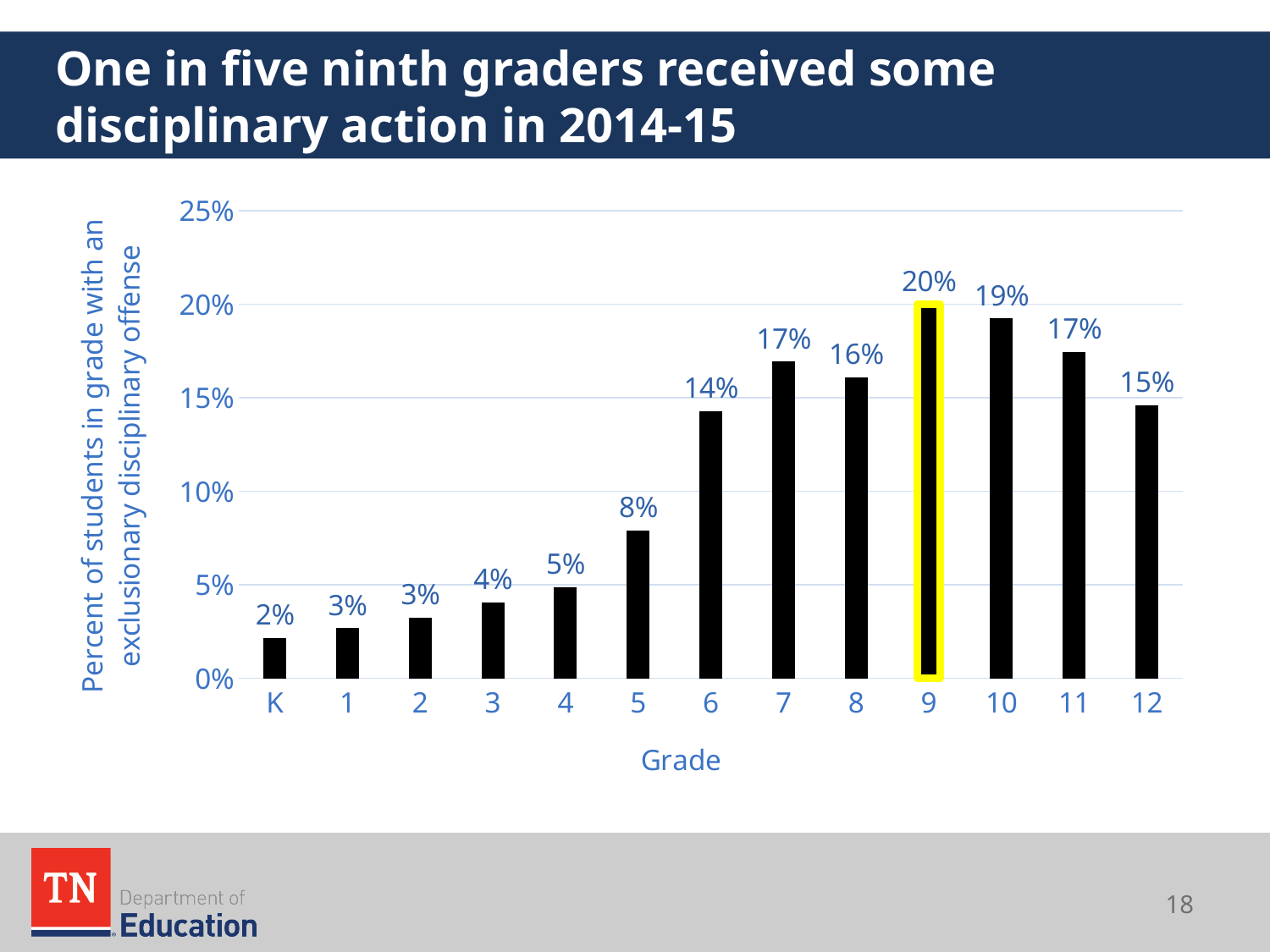
What is the difference between the values for grade 9 and grade 12? 5% Which grade has the lowest percent of students with an exclusionary disciplinary offense? K Which grade has a larger value, grade 8 or grade 10? 10 What percent of students in grade 9 had an exclusionary disciplinary offense? 20% Which grade's bar is highlighted with a yellow outline? 9 What kind of chart is shown on the slide? bar chart What is the difference between the values for grade 6 and grade 5? 6% How many grade categories are shown on the x axis? 13 What is the value shown for grade K? 2% Which grade has the highest percent of students with an exclusionary disciplinary offense? 9 Is the value for grade 7 greater or less than 15%? greater What is the value shown for grade 6? 14%